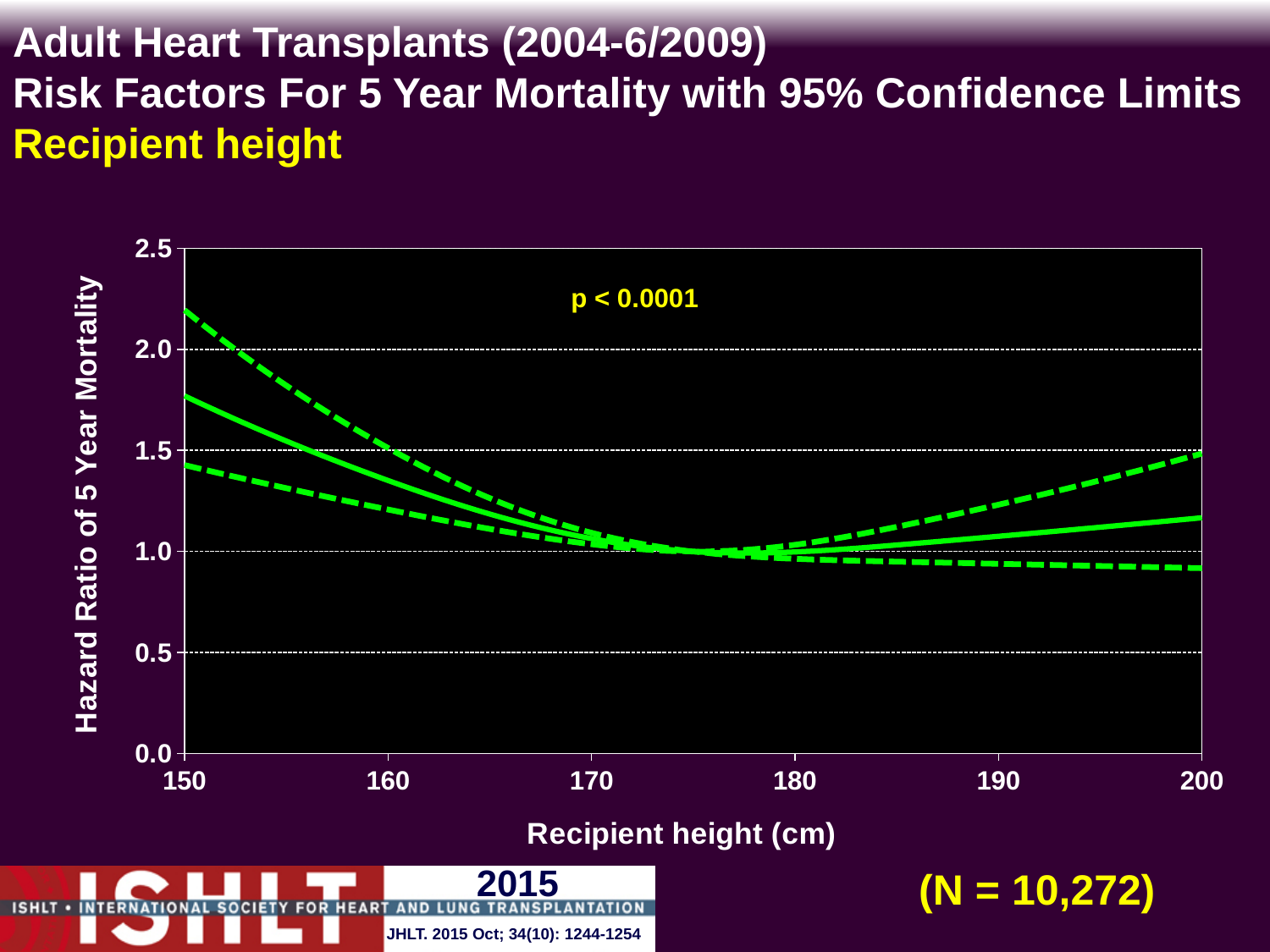
Is the upper dashed confidence limit at a recipient height of 150 cm greater or less than 2.0? greater What p-value is printed on the chart? p < 0.0001 What kind of chart is shown on the slide? Line chart Which is larger: the solid-line hazard ratio at 150 cm or at 200 cm? 150 cm Is the lower dashed confidence limit at a recipient height of 200 cm greater or less than 1.0? less Is the hazard ratio on the solid line at a recipient height of 200 cm greater or less than 1.5? less What is the label of the y axis? Hazard Ratio of 5 Year Mortality Does the solid hazard ratio line rise or fall as recipient height increases from 150 cm to 170 cm? fall What is the label of the x axis? Recipient height (cm) Does the solid hazard ratio line rise or fall as recipient height increases from 180 cm to 200 cm? rise How many lines are plotted on the chart? 3